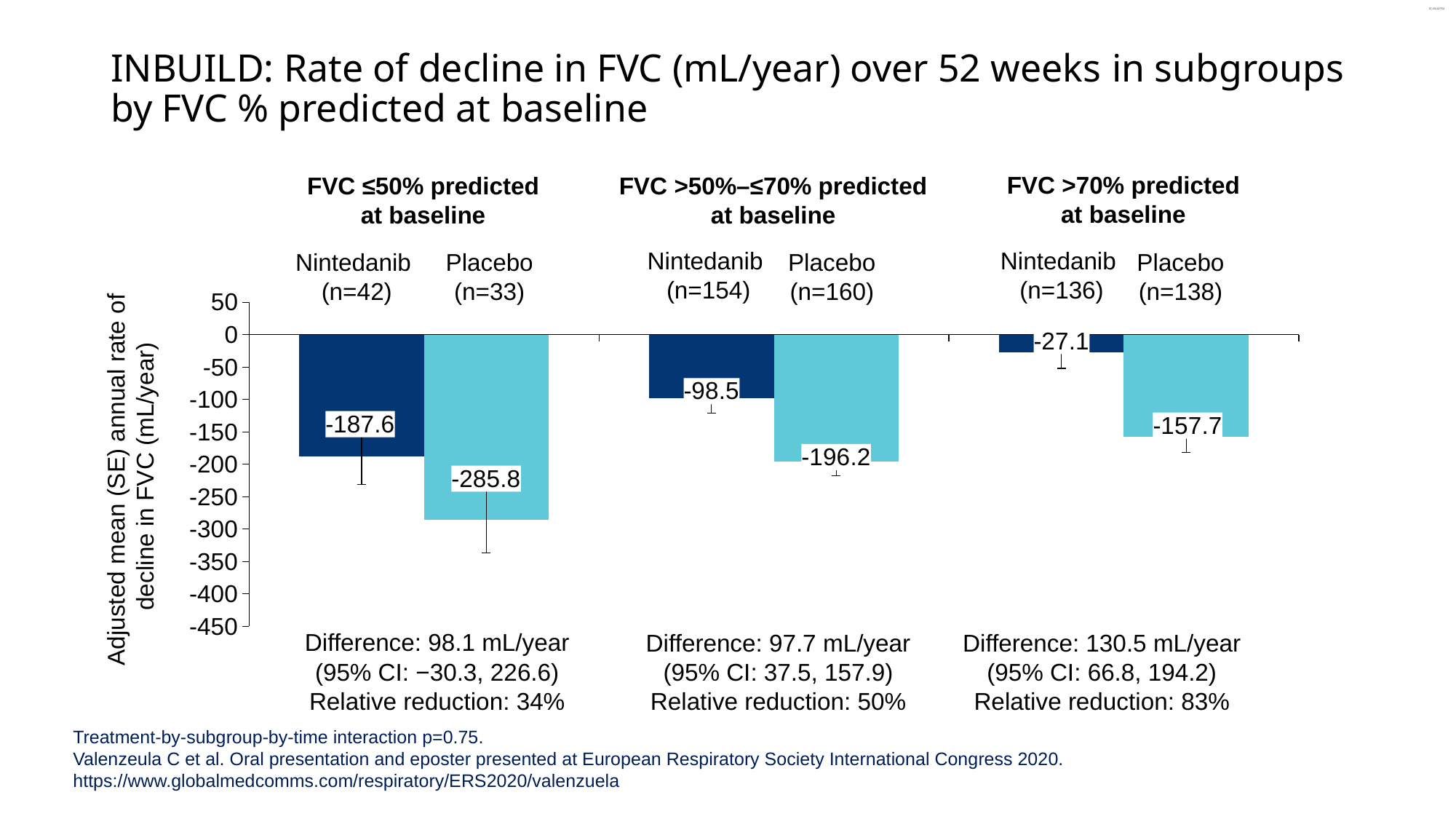
What is the adjusted mean annual rate of decline in FVC for Nintedanib in the FVC >70% predicted at baseline subgroup? -27.1 What is the adjusted mean annual rate of decline in FVC for Placebo in the FVC >50%–≤70% predicted at baseline subgroup? -196.2 How many bars are plotted in the chart? 6 Which bar shows the smallest decline in FVC (the value closest to zero)? Nintedanib in the FVC >70% predicted at baseline subgroup (-27.1) What is the difference between the Nintedanib values in the FVC >50%–≤70% subgroup (-98.5) and the FVC >70% subgroup (-27.1)? 71.4 What is the adjusted mean annual rate of decline in FVC for Placebo in the FVC >70% predicted at baseline subgroup? -157.7 What is the relative reduction reported for the FVC >70% predicted at baseline subgroup? 83% Which bar shows the largest decline in FVC (the most negative value)? Placebo in the FVC ≤50% predicted at baseline subgroup (-285.8) In the FVC >70% predicted at baseline subgroup, which group has the greater decline in FVC, Nintedanib or Placebo? Placebo What is the adjusted mean annual rate of decline in FVC for Nintedanib in the FVC ≤50% predicted at baseline subgroup? -187.6 What type of chart is shown on the slide? Bar chart Is the Placebo value in the FVC ≤50% predicted subgroup greater or less than -250? less